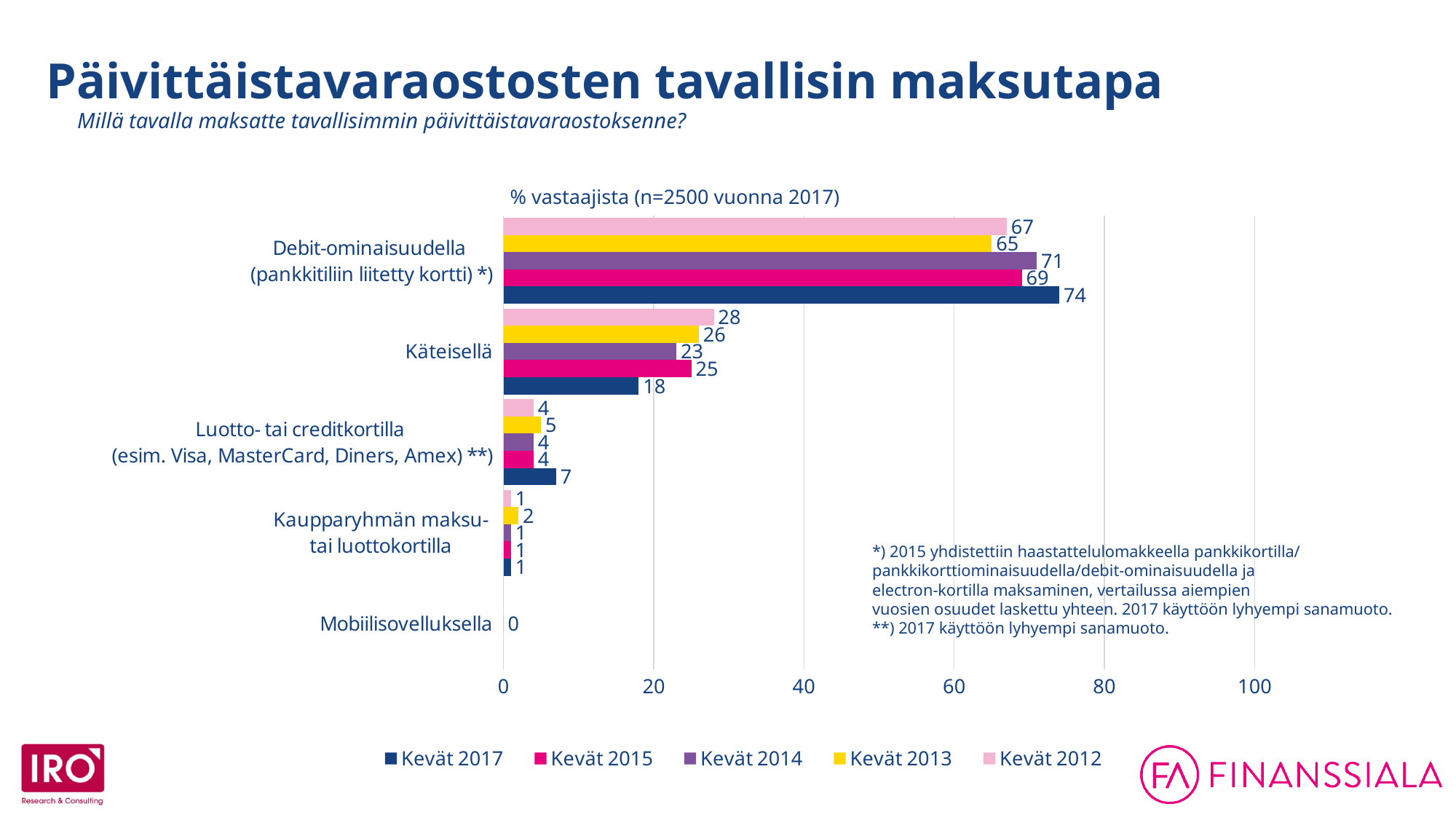
What kind of chart is shown on the slide? bar chart What is the value for Debit-ominaisuudella in Kevät 2017? 74 What is the difference between the Kevät 2017 and Kevät 2012 values for Käteisellä? 10 What is the axis title shown above the chart? % vastaajista (n=2500 vuonna 2017) What is the value for Luotto- tai creditkortilla in Kevät 2013? 5 How many series does the legend list? 5 What is the value for Käteisellä in Kevät 2012? 28 How many payment method categories are shown on the chart? 5 What is the value for Kaupparyhmän maksu- tai luottokortilla in Kevät 2013? 2 Which is larger for Debit-ominaisuudella: the Kevät 2014 value or the Kevät 2013 value? Kevät 2014 Which payment method has the highest value in Kevät 2017? Debit-ominaisuudella (pankkitiliin liitetty kortti)